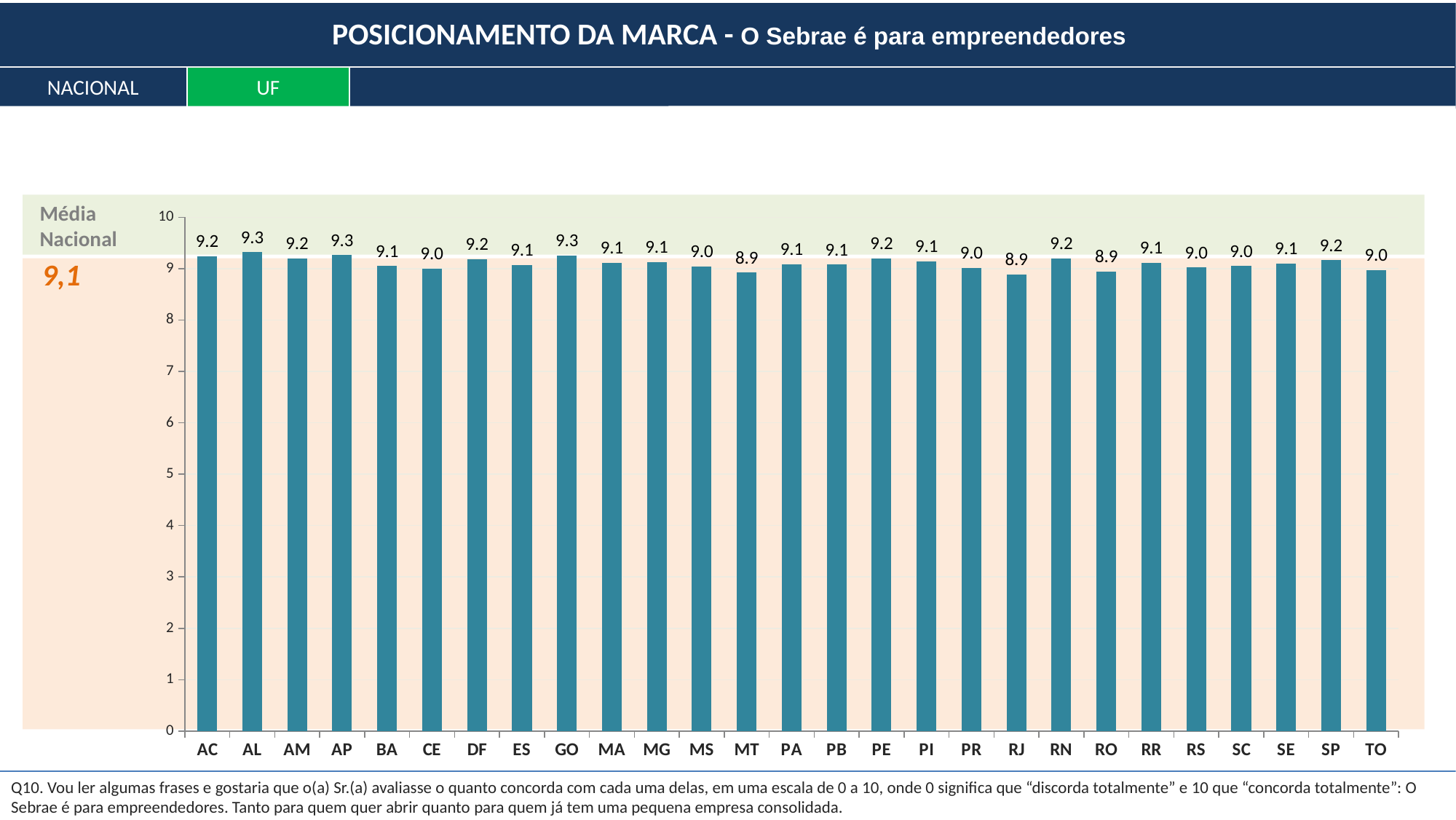
What is the Média Nacional value shown on the slide? 9,1 What kind of chart is shown on the slide? bar chart Which is larger, the value for AP or the value for RO? AP What is the title of the slide? POSICIONAMENTO DA MARCA - O Sebrae é para empreendedores What is the difference between the values for AC and RS? 0.2 Is the value for PR greater or less than 8? greater What is the value for AL? 9.3 How many states (UF) are shown on the x axis? 27 What is the value for RJ? 8.9 What is the difference between the values for GO and MT? 0.4 What is the value for CE? 9.0 What is the value for SP? 9.2